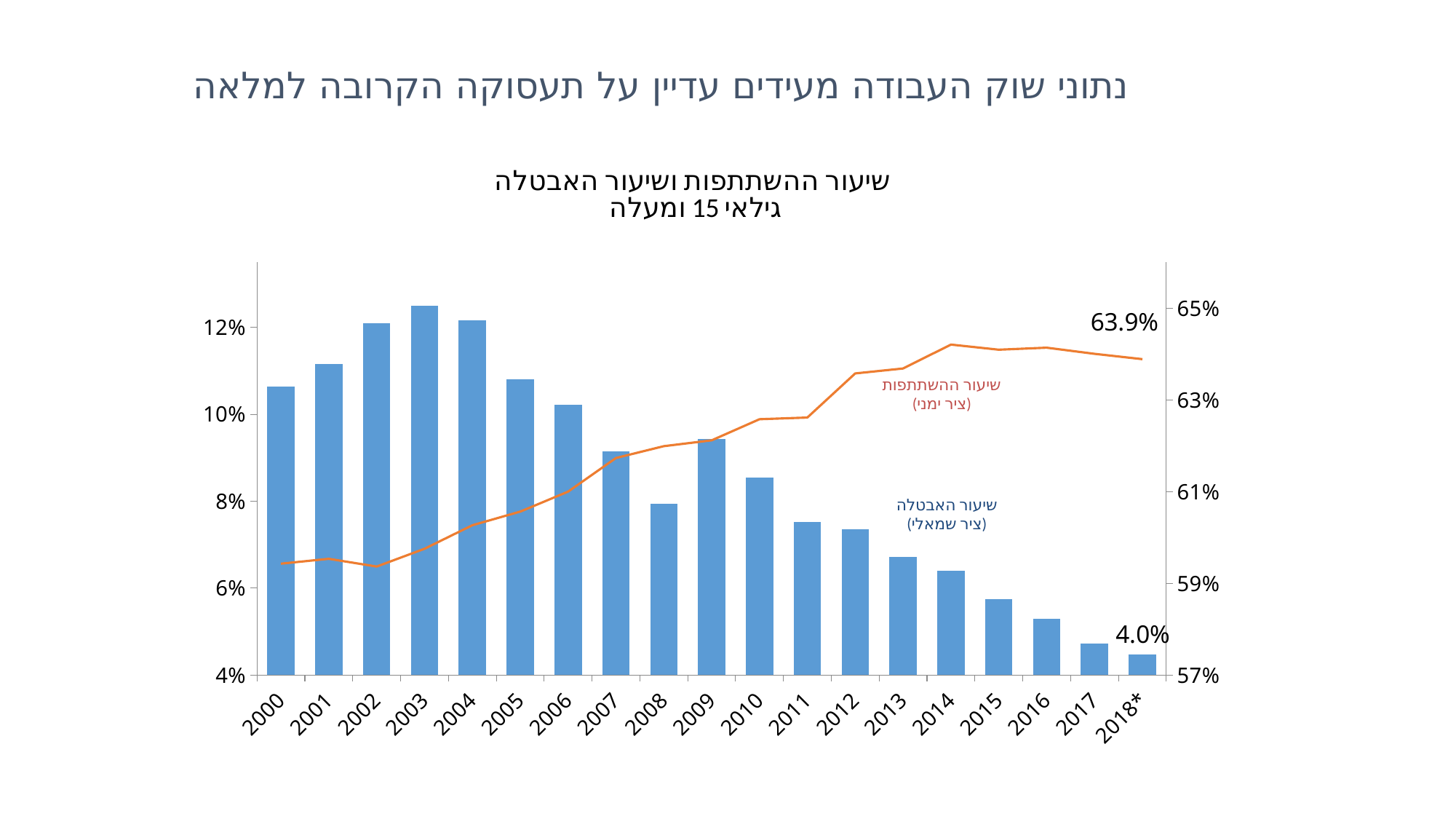
What is the unemployment rate (שיעור האבטלה) shown for 2018*? 4.0% Which year has a higher unemployment rate, 2002 or 2005? 2002 How many years are shown on the x axis? 19 Does the unemployment rate rise or fall from 2003 to 2018*? Fall In which year is the unemployment rate bar the highest? 2003 On which axis is the participation rate (שיעור ההשתתפות) plotted? Right axis What kind of chart is this? Bar chart with a line Is the unemployment rate for 2000 greater or less than 10%? greater Does the participation rate line generally rise or fall from 2000 to 2014? Rise What is the participation rate (שיעור ההשתתפות) shown for 2018*? 63.9% In which year is the unemployment rate bar the lowest? 2018* Is the unemployment rate for 2016 greater or less than 6%? less